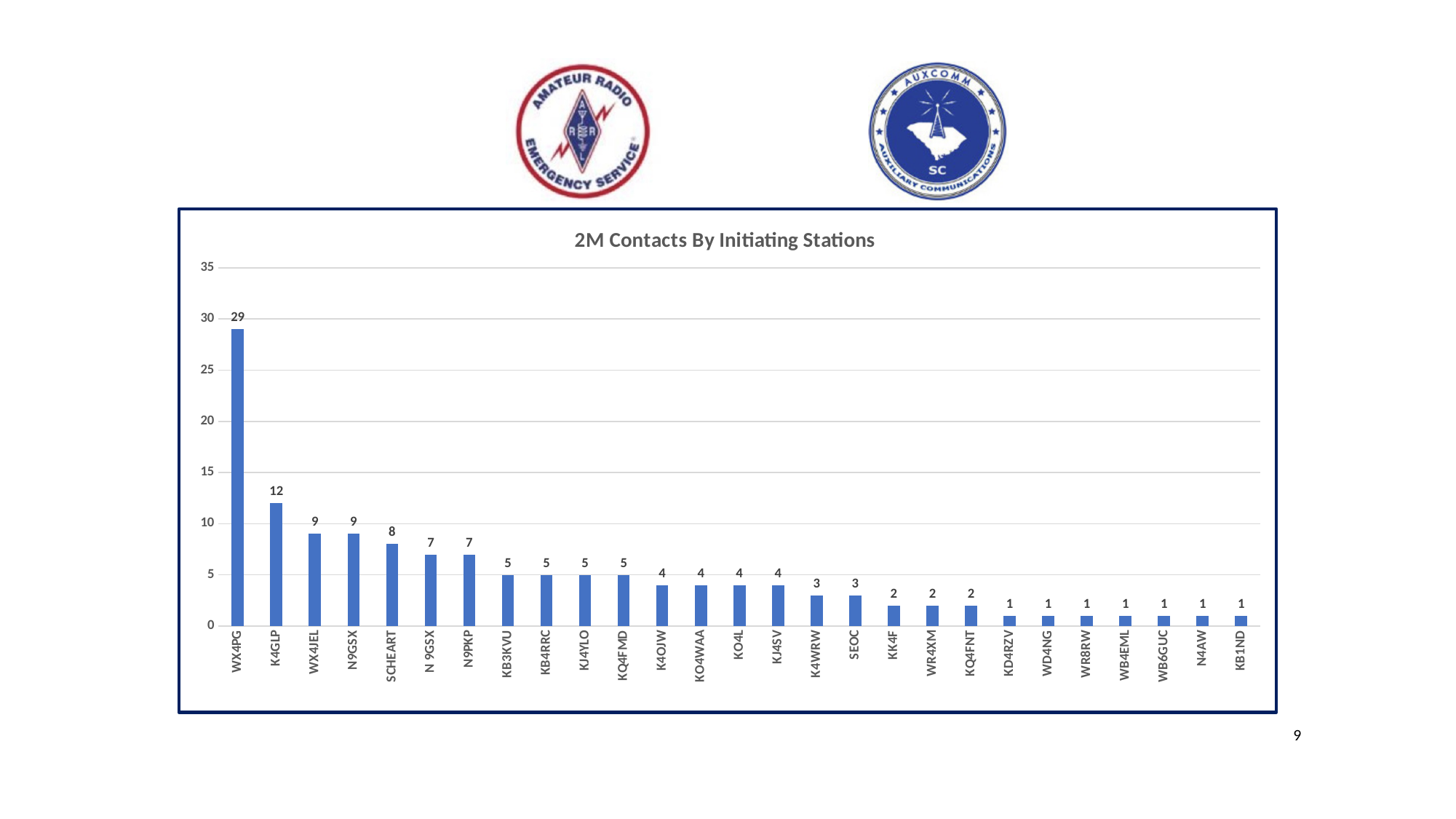
What type of chart is shown on the slide? bar chart How many 2M contacts did WX4PG initiate? 29 Do the values rise or fall moving from left to right along the x axis? fall What is the value for SCHEART? 8 Which has a larger value, N9PKP or KB3KVU? N9PKP Is the value for WX4PG greater or less than 25? greater How many stations are shown on the x axis? 27 How many 2M contacts did K4GLP initiate? 12 What is the difference between the values for WX4PG and K4GLP? 17 Which station has the highest number of 2M contacts? WX4PG What is the title of the chart? 2M Contacts By Initiating Stations What is the value for SEOC? 3